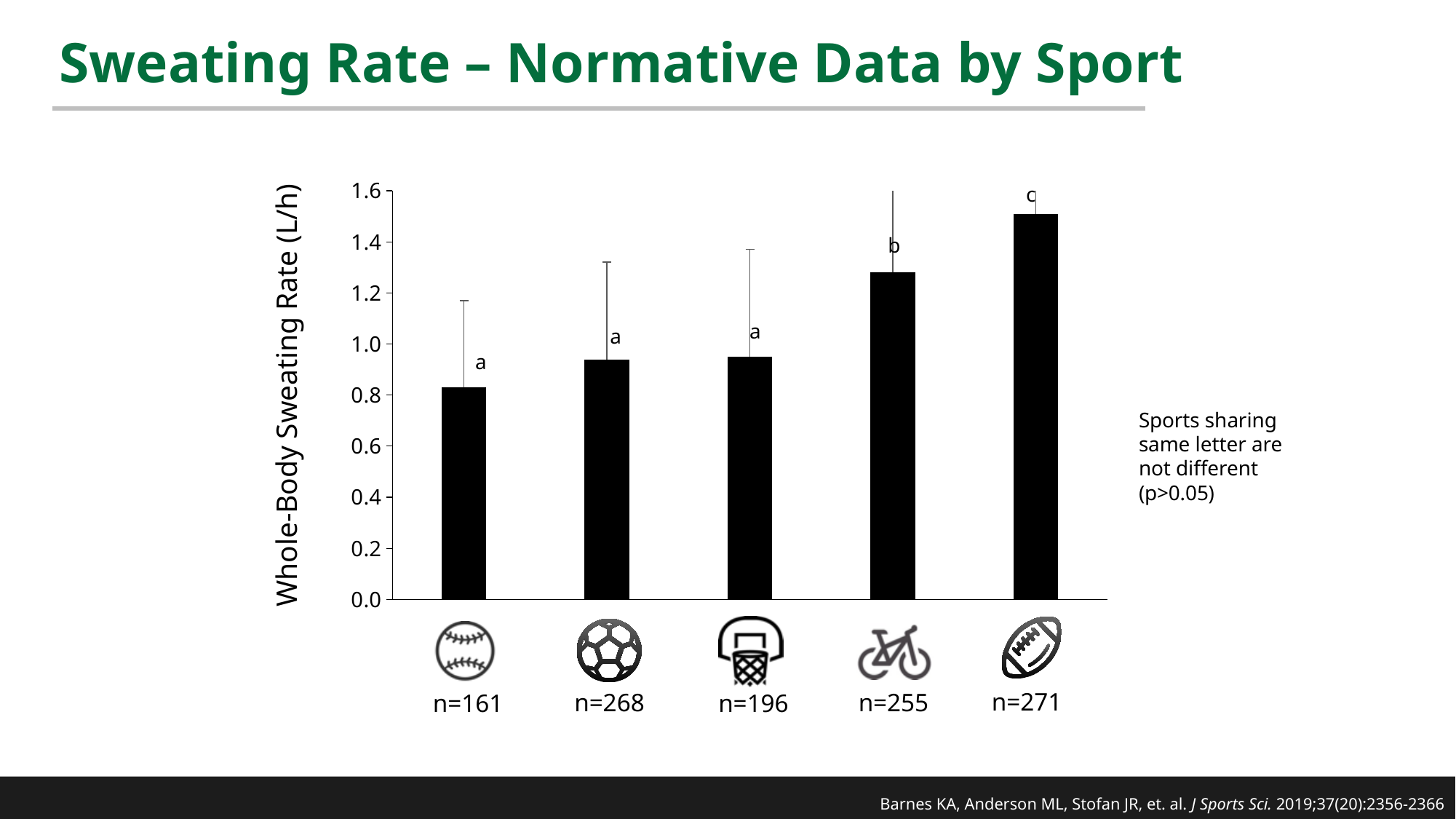
Is the whole-body sweating rate for the n=268 (soccer) bar greater or less than 1.0 L/h? less Do the bar values generally rise or fall from left to right along the x axis? rise Which bar has the lowest whole-body sweating rate? n=161 (baseball) What is the label of the y axis? Whole-Body Sweating Rate (L/h) Which bar has the highest whole-body sweating rate? n=271 (American football) Is the whole-body sweating rate for the n=161 (baseball) bar greater or less than 1.0 L/h? less Is the whole-body sweating rate for the n=271 (American football) bar greater or less than 1.4 L/h? greater Which significance letter is shown above the n=255 (cycling) bar? b What kind of chart is shown on the slide? bar chart Which has a higher whole-body sweating rate, the n=255 (cycling) bar or the n=196 (basketball) bar? n=255 (cycling) How many bars (sports) are plotted in the chart? 5